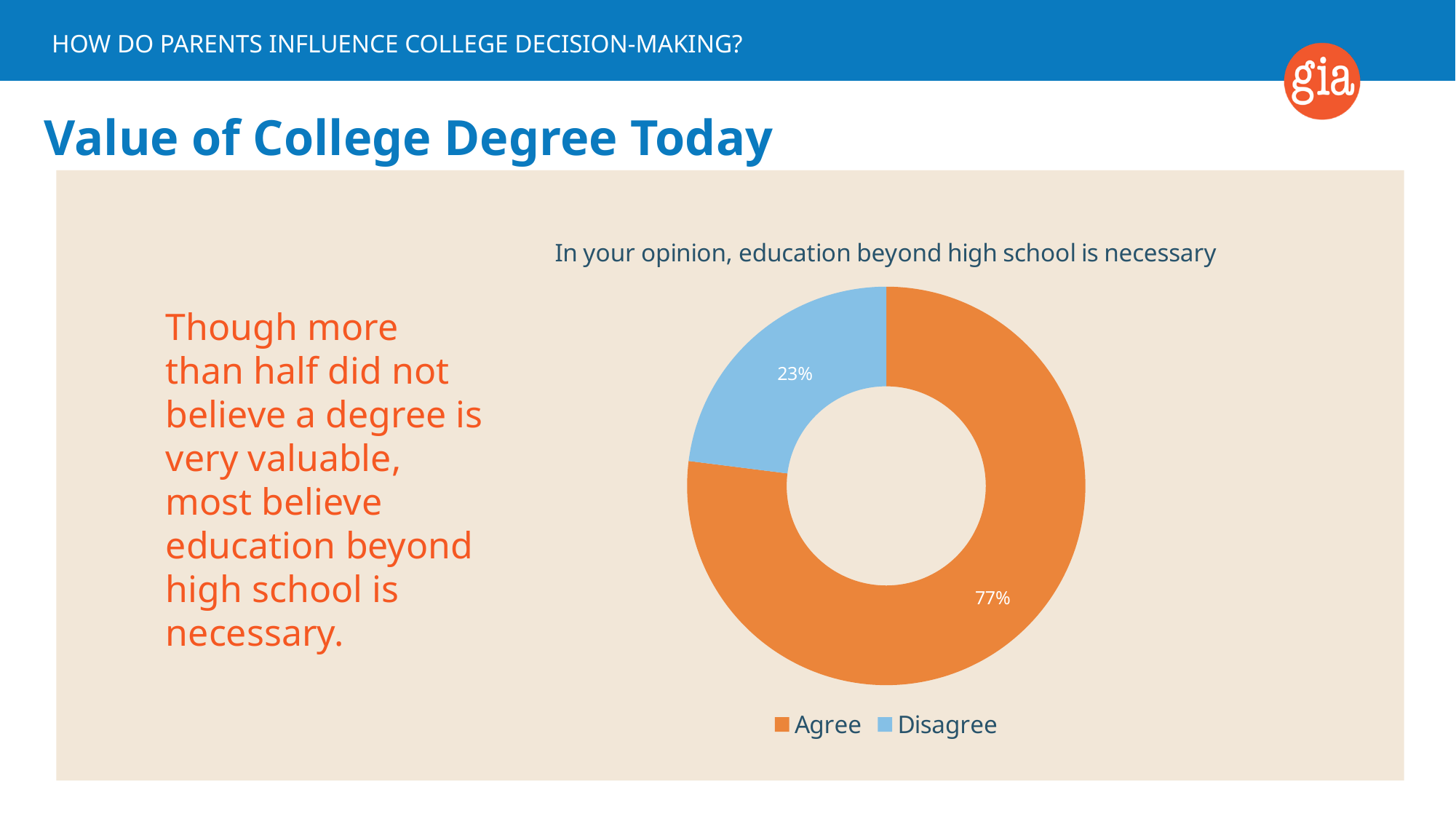
Which response has the largest share of the chart? Agree What share of the chart does the Disagree slice represent? 23% How many categories does the chart show? 2 What kind of chart is shown on the slide? Doughnut chart What percentage of respondents Disagree that education beyond high school is necessary? 23% Which is larger, the share for Agree or the share for Disagree? Agree Which response has the smallest share of the chart? Disagree What colour is the Agree slice in the chart? Orange How many entries does the legend list? 2 What is the difference in percentage points between Agree and Disagree? 54 What is the title of the chart? In your opinion, education beyond high school is necessary What percentage of respondents Agree that education beyond high school is necessary? 77%